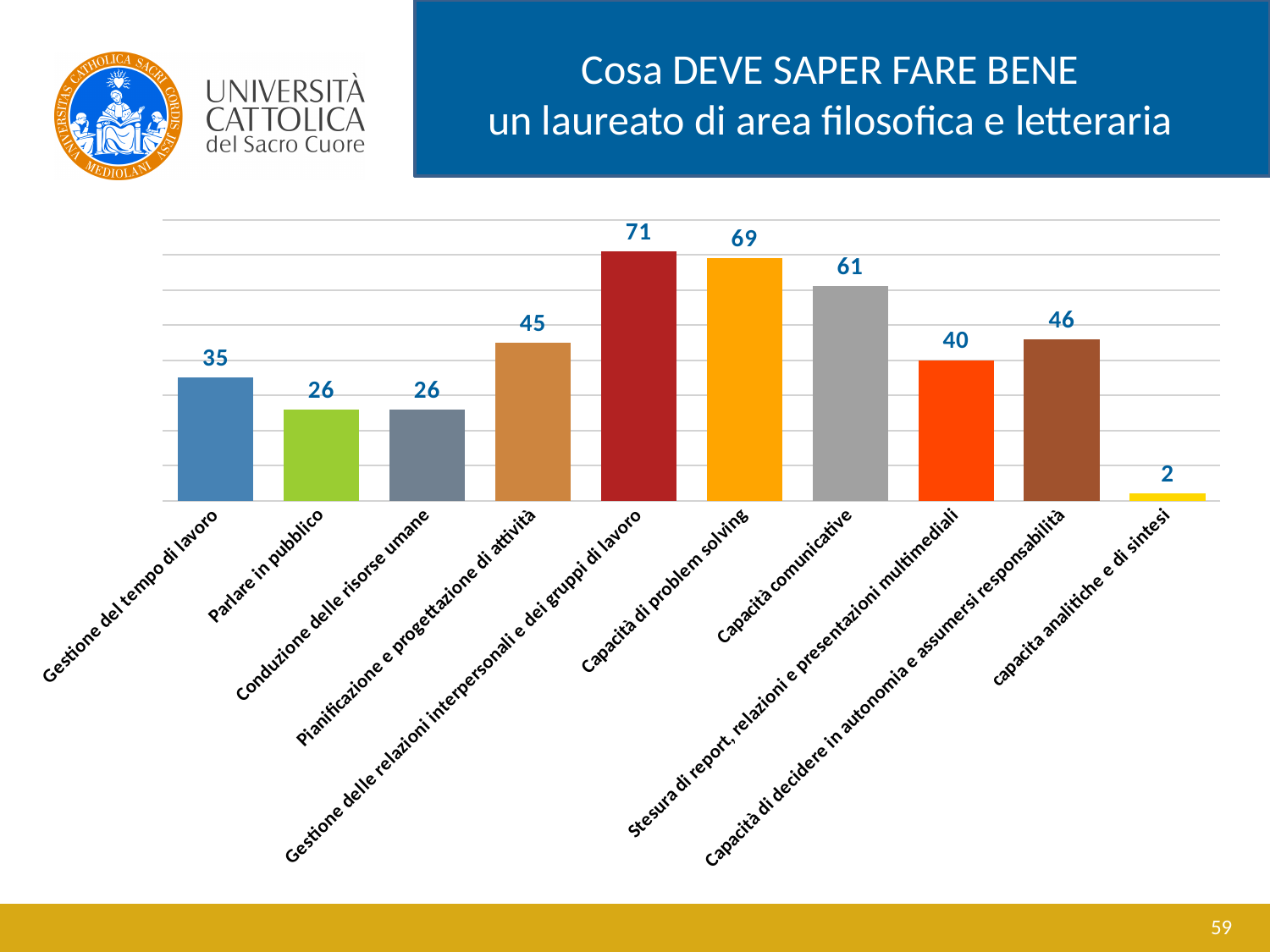
What is the difference between the values for Gestione delle relazioni interpersonali e dei gruppi di lavoro and Capacità di problem solving? 2 Which two categories share the same value of 26? Parlare in pubblico and Conduzione delle risorse umane What is the value for Capacità di problem solving? 69 What is the title of the slide containing the chart? Cosa DEVE SAPER FARE BENE un laureato di area filosofica e letteraria What kind of chart is shown on the slide? bar chart What is the value for Stesura di report, relazioni e presentazioni multimediali? 40 Which category has the lowest value? capacita analitiche e di sintesi Which is larger, the value for Capacità di decidere in autonomia e assumersi responsabilità or the value for Stesura di report, relazioni e presentazioni multimediali? Capacità di decidere in autonomia e assumersi responsabilità How many categories are shown in the chart? 10 What is the value for Gestione del tempo di lavoro? 35 What is the difference between the values for Capacità comunicative and Pianificazione e progettazione di attività? 16 Which category has the highest value? Gestione delle relazioni interpersonali e dei gruppi di lavoro